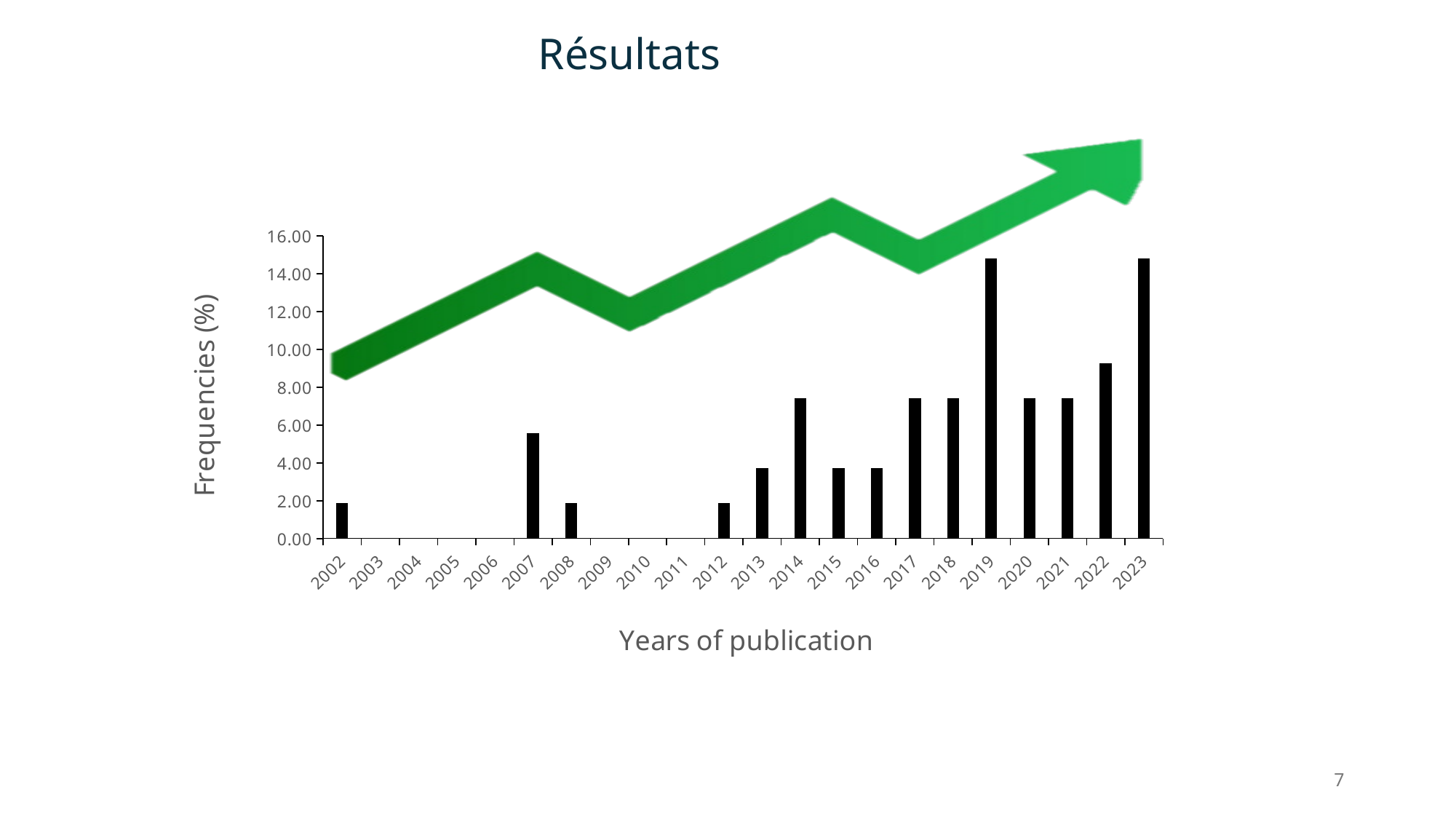
What is the title of the y axis? Frequencies (%) What kind of chart is shown on the slide? bar chart Do the values generally rise or fall from 2002 to 2023? rise Is the value for 2022 greater or less than 8.00? greater Which year has the larger value, 2020 or 2022? 2022 Which year has the larger value, 2014 or 2015? 2014 Is the value for 2014 greater or less than 8.00? less Is the value for 2002 greater or less than 4.00? less What is the title of the x axis? Years of publication How many years are labelled along the x axis of the chart? 22